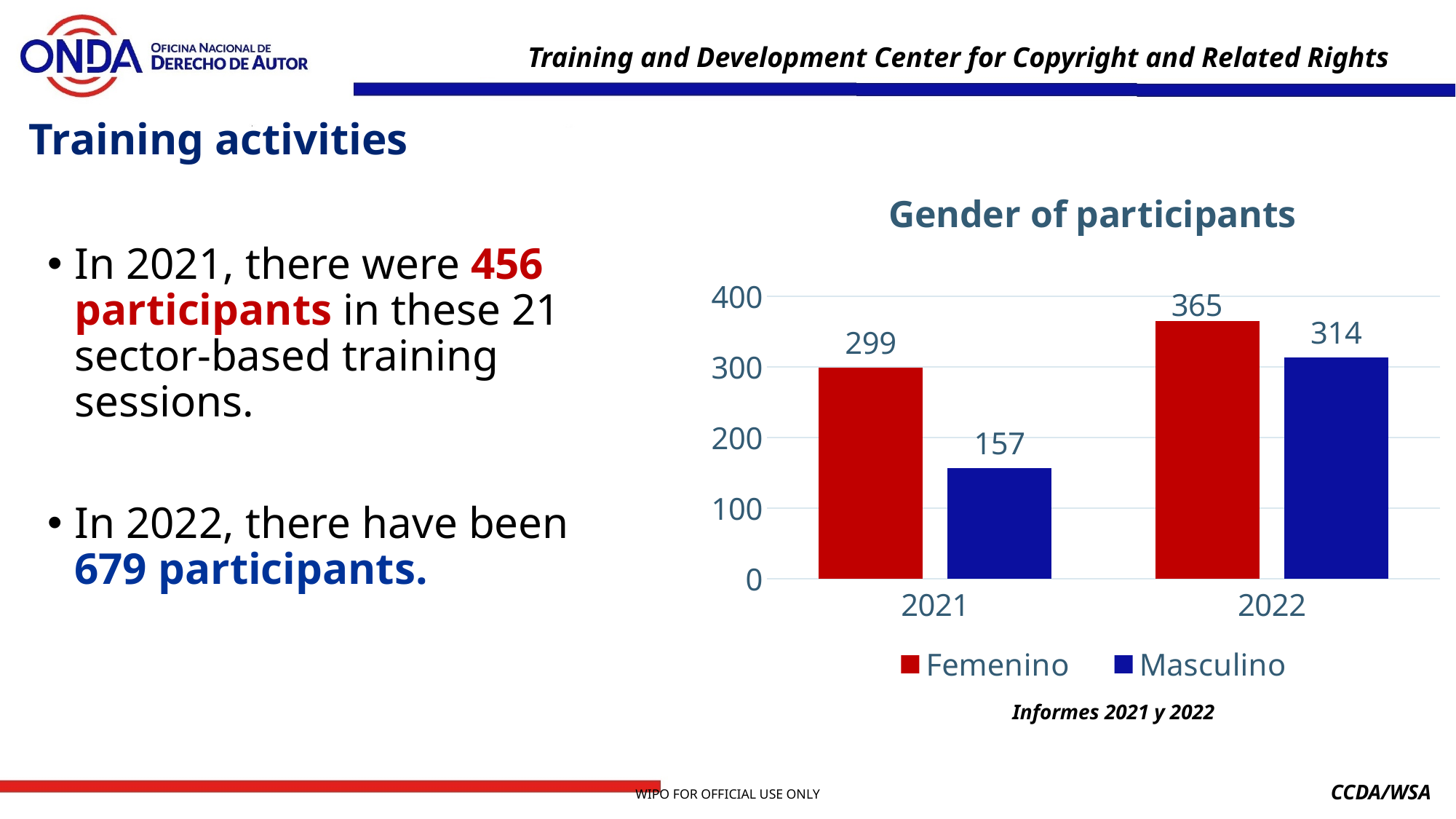
What is the value for Femenino in 2021? 299 What is the value for Masculino in 2021? 157 What kind of chart is shown on the slide? Bar chart What is the difference between the Femenino and Masculino values in 2021? 142 What is the value for Femenino in 2022? 365 Which bar has the highest value in the chart? Femenino in 2022 What is the value for Masculino in 2022? 314 What is the difference between the Femenino values for 2022 and 2021? 66 Which is larger in 2022, Femenino or Masculino? Femenino How many series does the legend list? 2 Which bar has the lowest value in the chart? Masculino in 2021 What is the title of the chart? Gender of participants